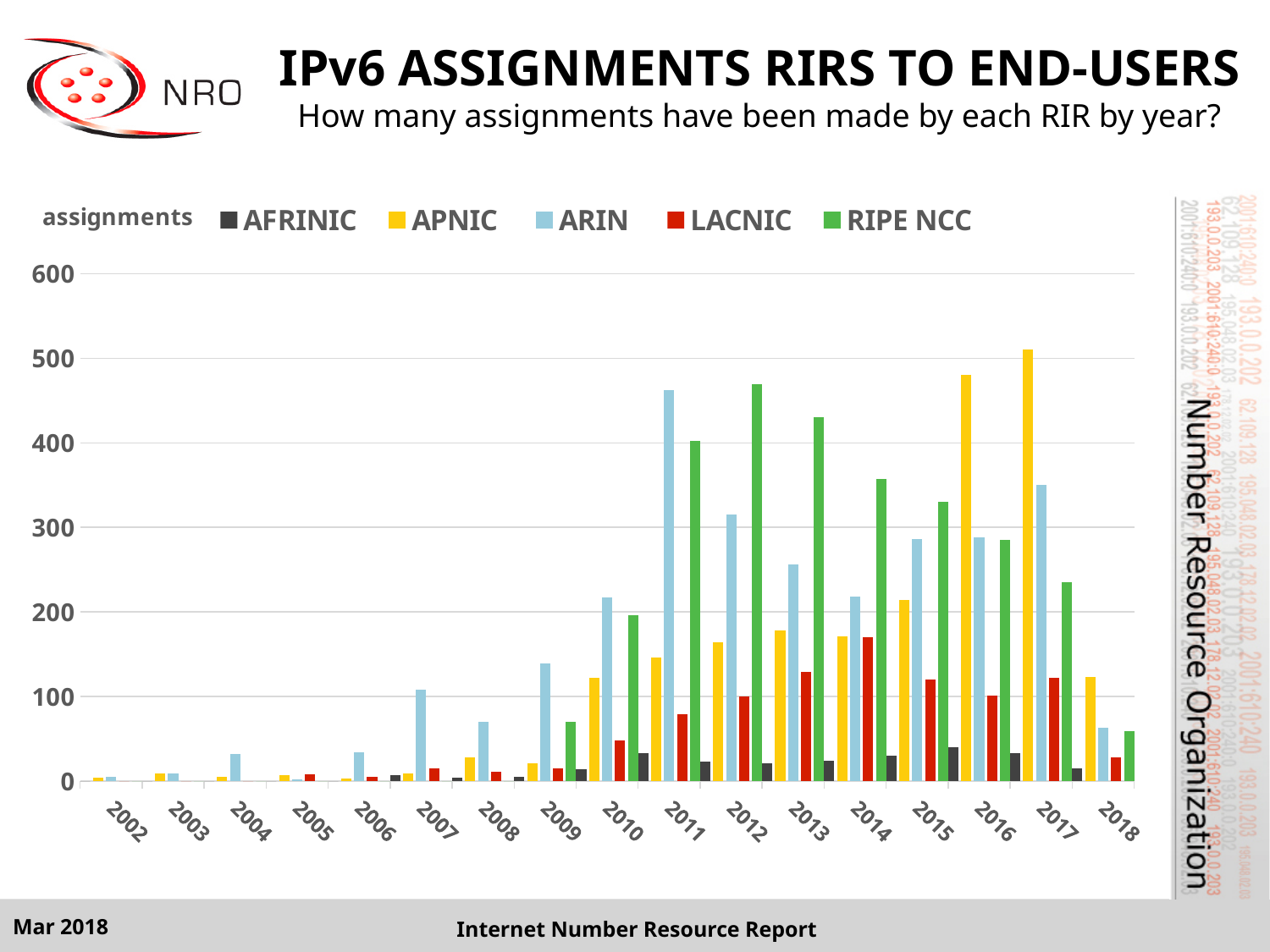
Is the value for LACNIC in 2017 greater or less than 100? greater Which RIR has the shortest bar in 2017? AFRINIC Which RIR has the tallest bar in 2011? ARIN Is the value for ARIN in 2011 greater or less than 400? greater Is the value for APNIC in 2017 greater or less than 500? greater In 2014, which is larger: the value for ARIN or the value for RIPE NCC? RIPE NCC Which RIR has the tallest bar in 2017? APNIC Which RIR has the tallest bar in 2012? RIPE NCC How many years are shown along the x axis? 17 What colour are the APNIC bars? yellow How many series does the legend list? 5 What kind of chart is shown on the slide? bar chart